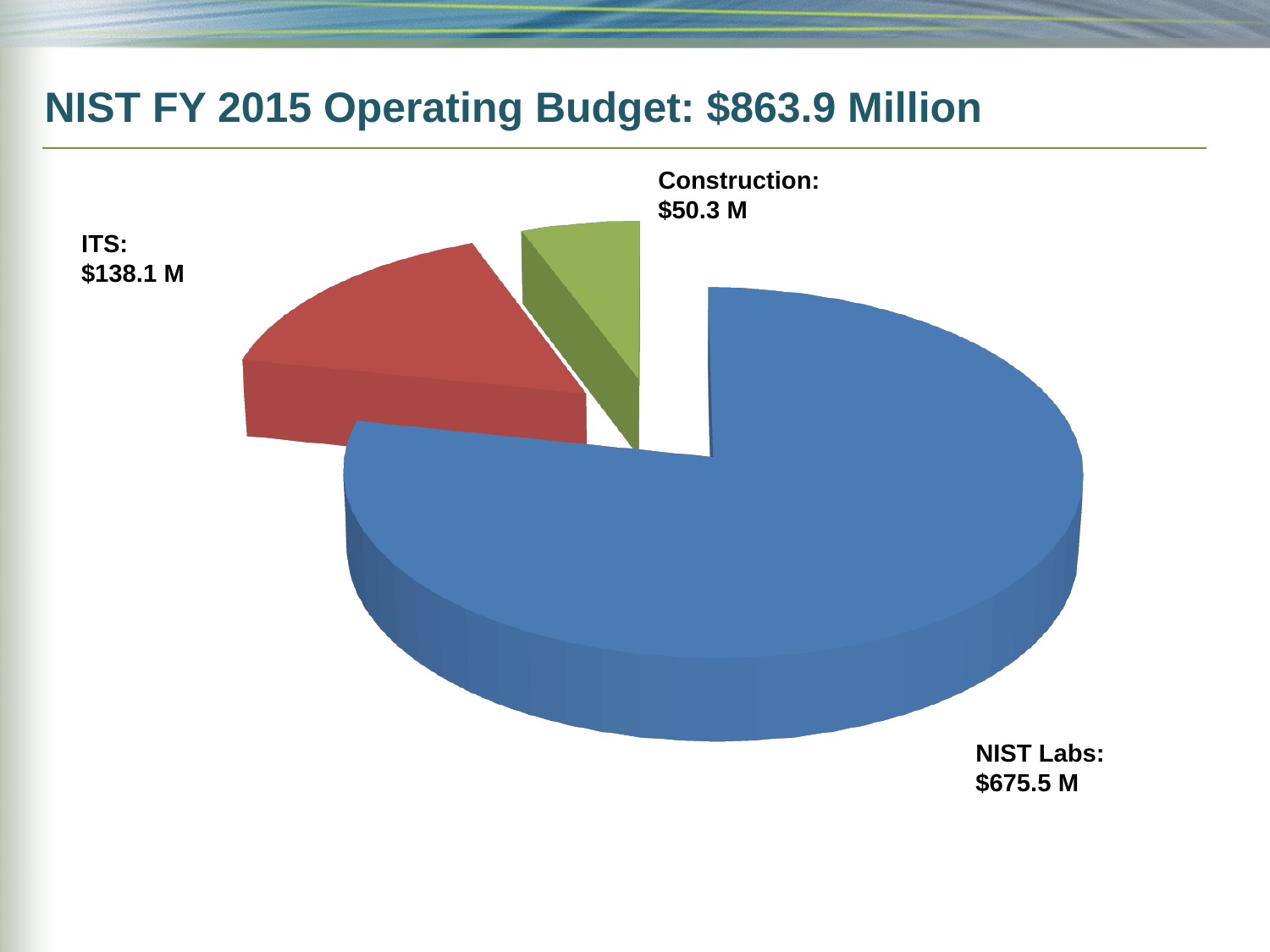
What is the total of the three slices shown in the pie chart? $863.9 M What kind of chart is shown on the slide? Pie chart What is the value for NIST Labs? $675.5 M What is the difference between the NIST Labs value and the ITS value? $537.4 M What is the value for Construction? $50.3 M What is the value for ITS? $138.1 M What is the difference between the ITS value and the Construction value? $87.8 M What is the title of the slide containing the pie chart? NIST FY 2015 Operating Budget: $863.9 Million Which is larger, the ITS value or the Construction value? ITS Which category has the smallest slice of the pie? Construction How many slices does the pie chart have? 3 Which category has the largest slice of the pie? NIST Labs